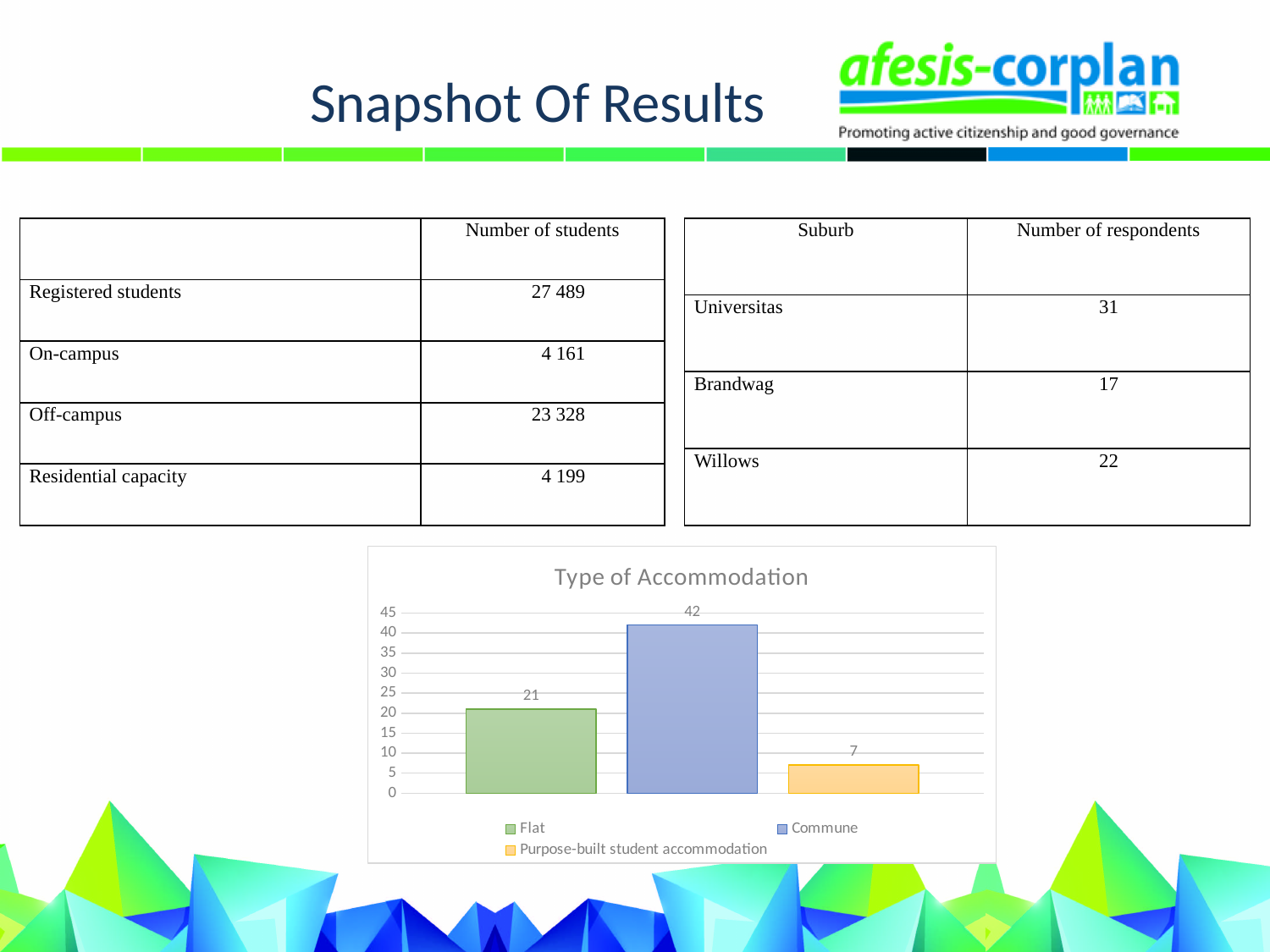
Which is larger in the Type of Accommodation chart, Flat or Commune? Commune Which type of accommodation has the lowest value in the chart? Purpose-built student accommodation What kind of chart is the Type of Accommodation chart? bar chart What is the difference between the values for Commune and Flat in the Type of Accommodation chart? 21 How many series does the legend of the Type of Accommodation chart list? 3 Is the value for Commune greater or less than 40 in the Type of Accommodation chart? greater What is the difference between the values for Flat and Purpose-built student accommodation in the chart? 14 What is the title of the chart on the slide? Type of Accommodation What is the value for Commune in the Type of Accommodation chart? 42 What is the value for Flat in the Type of Accommodation chart? 21 Which type of accommodation has the highest value in the chart? Commune What is the value for Purpose-built student accommodation in the Type of Accommodation chart? 7